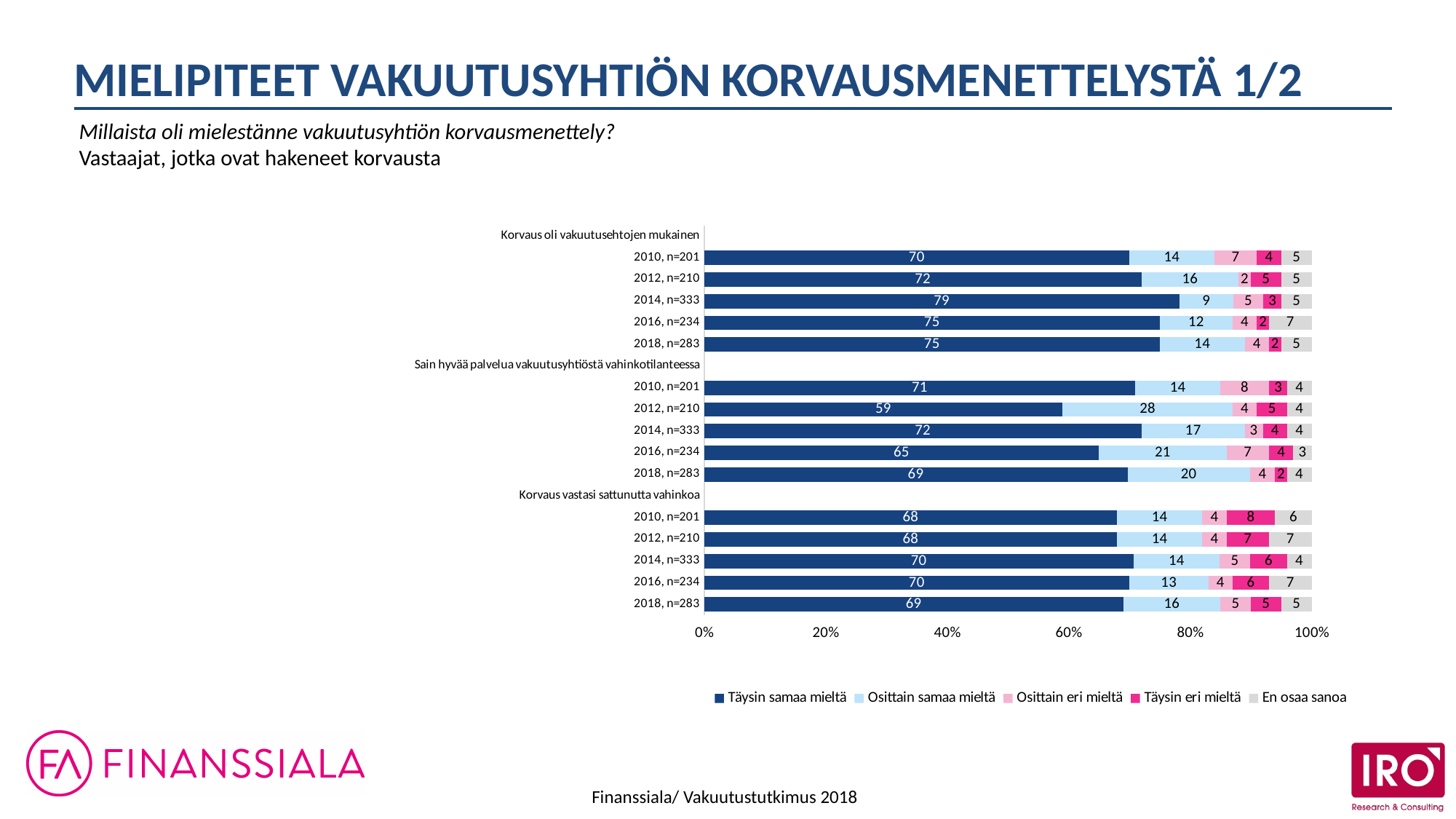
What is the 'Täysin eri mieltä' value for 2010 (n=201) under 'Korvaus vastasi sattunutta vahinkoa'? 8 Which year has the highest 'Täysin samaa mieltä' value under 'Korvaus oli vakuutusehtojen mukainen'? 2014, n=333 Which bar on the chart has the lowest 'Täysin samaa mieltä' value? 2012, n=210 under 'Sain hyvää palvelua vakuutusyhtiöstä vahinkotilanteessa' How many series does the legend list? 5 Under 'Sain hyvää palvelua vakuutusyhtiöstä vahinkotilanteessa', which year has the larger 'Täysin samaa mieltä' value: 2016 or 2018? 2018 What is the 'Osittain samaa mieltä' value for 2012 (n=210) under 'Sain hyvää palvelua vakuutusyhtiöstä vahinkotilanteessa'? 28 Under 'Korvaus vastasi sattunutta vahinkoa', does the 'Täysin eri mieltä' value rise or fall from 2010 to 2018? Fall How many stacked bars are plotted on the chart? 15 What is the difference between the 'Täysin samaa mieltä' values for 2014 and 2010 under 'Korvaus oli vakuutusehtojen mukainen'? 9 What is the total of the stacked bar for 2016 (n=234) under 'Sain hyvää palvelua vakuutusyhtiöstä vahinkotilanteessa'? 100 What percentage of respondents in 2018 (n=283) fully agreed (Täysin samaa mieltä) that 'Korvaus oli vakuutusehtojen mukainen'? 75 What type of chart is shown on the slide? Stacked bar chart